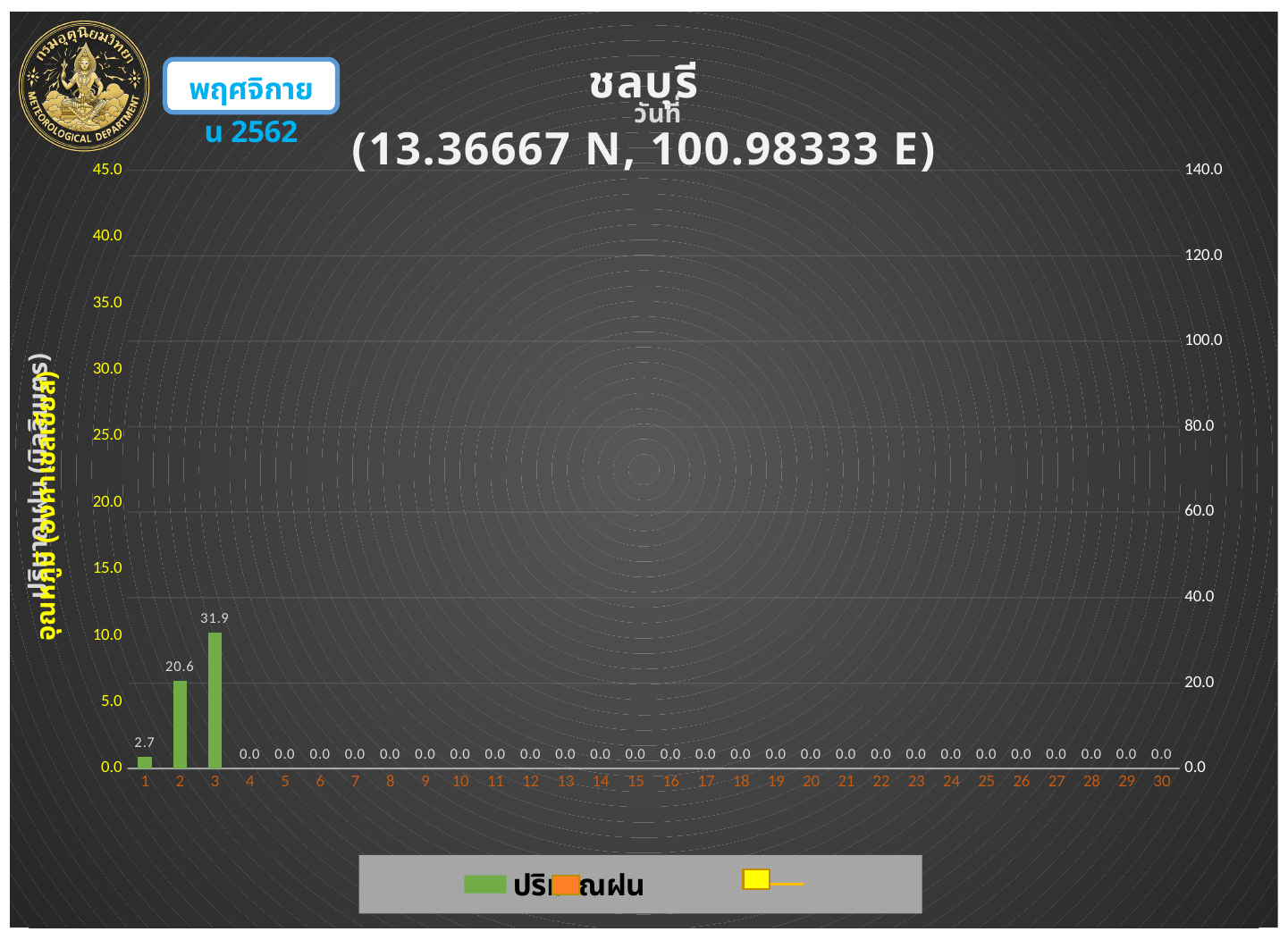
What coordinates are shown in the chart title? (13.36667 N, 100.98333 E) How many days have a rainfall value greater than 0.0? 3 What is the difference between the rainfall values for day 2 and day 1? 17.9 Which day has the highest rainfall value? 3 What is the rainfall value for day 15? 0.0 Which is larger, the rainfall value for day 2 or for day 1? day 2 What is the rainfall value for day 1? 2.7 What is the difference between the rainfall values for day 3 and day 2? 11.3 What kind of chart is shown on the slide? bar chart What is the rainfall value for day 2? 20.6 What is the rainfall value for day 3? 31.9 How many days are shown on the x axis? 30